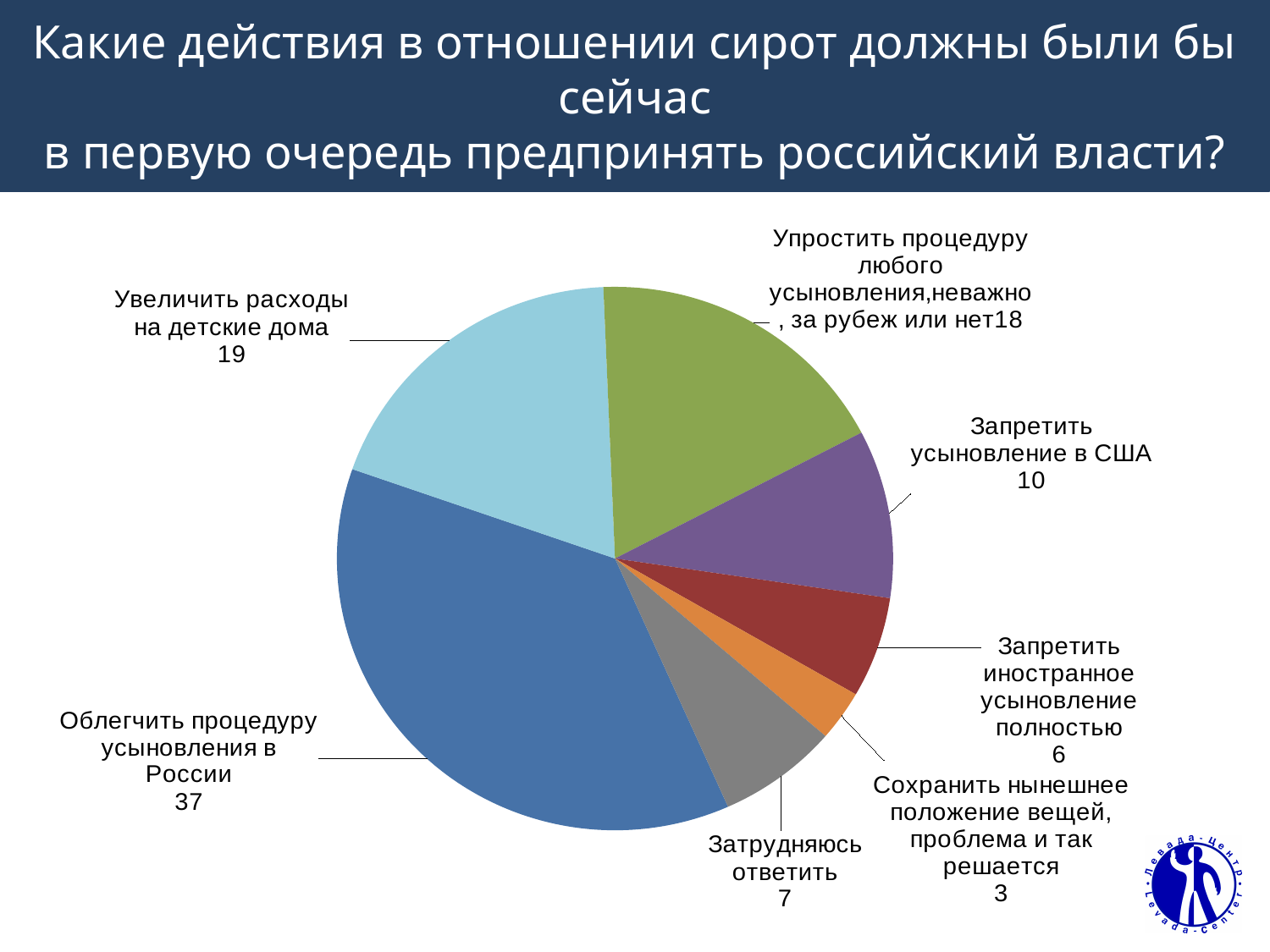
What kind of chart is shown on the slide? Pie chart What is the value for "Увеличить расходы на детские дома"? 19 What is the value for "Затрудняюсь ответить"? 7 Which category has the smallest slice of the pie? Сохранить нынешнее положение вещей, проблема и так решается Which category has the largest slice of the pie? Облегчить процедуру усыновления в России How many slices does the pie chart have? 7 What is the difference between the values for "Облегчить процедуру усыновления в России" and "Увеличить расходы на детские дома"? 18 What is the difference between the values for "Упростить процедуру любого усыновления, неважно, за рубеж или нет" and "Затрудняюсь ответить"? 11 What is the value for "Запретить усыновление в США"? 10 What is the value for "Облегчить процедуру усыновления в России"? 37 What share of the whole pie does the "Облегчить процедуру усыновления в России" slice represent? 37% Which is larger: the value for "Запретить усыновление в США" or the value for "Запретить иностранное усыновление полностью"? Запретить усыновление в США